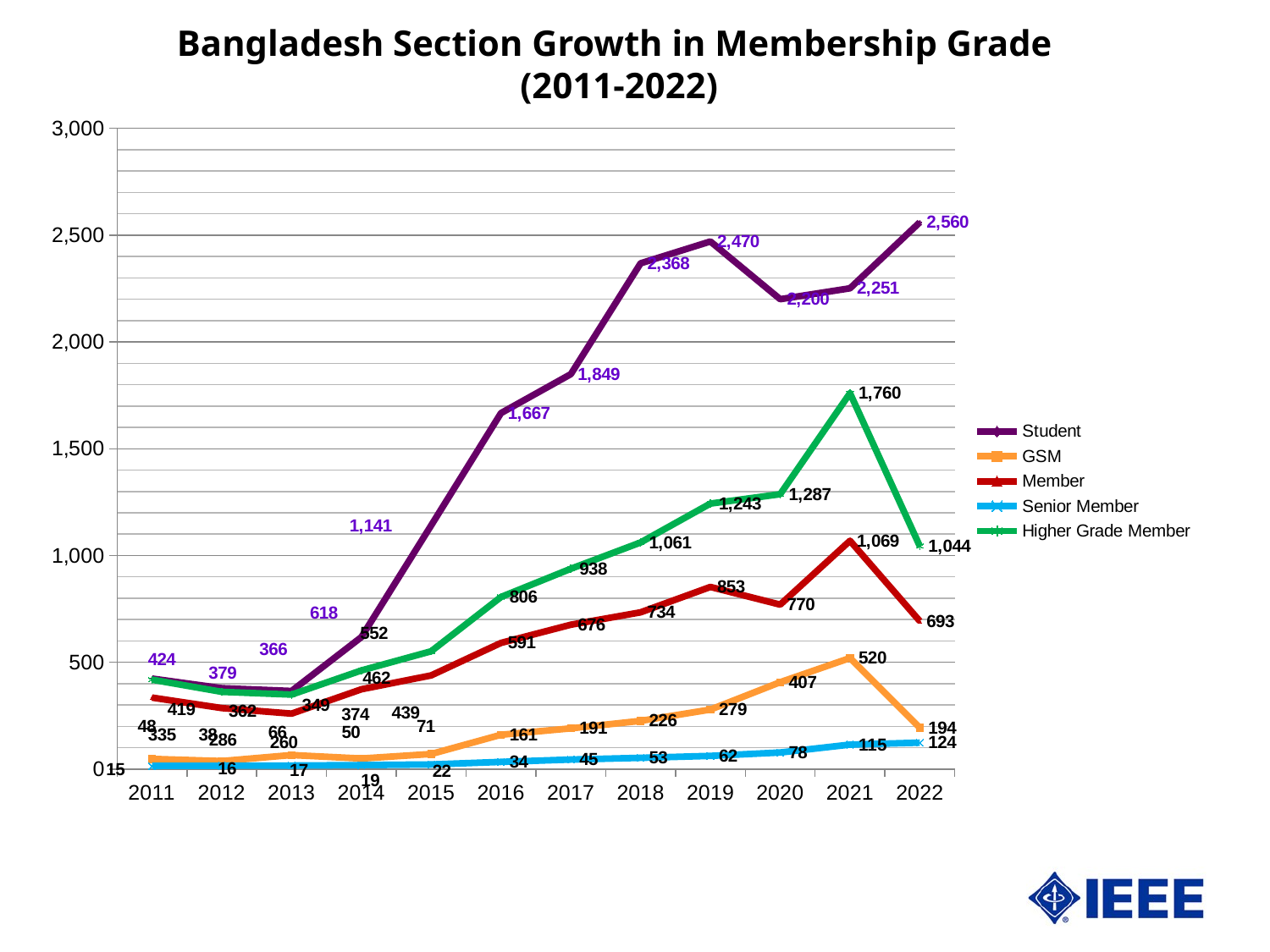
How many years are plotted along the x axis? 12 Does the Senior Member series rise or fall from 2011 to 2022? Rises What is the Student value for 2022? 2,560 What kind of chart is shown on the slide? Line chart Is the Student value for 2016 greater or less than 1,500? greater In which year is the Student series at its highest? 2022 What is the Higher Grade Member value for 2021? 1,760 What is the difference between the Student values for 2022 and 2021? 309 How many series does the legend list? 5 What is the GSM value for 2021? 520 In 2021, which is larger: Member or Higher Grade Member? Higher Grade Member In which year does the Higher Grade Member series peak? 2021